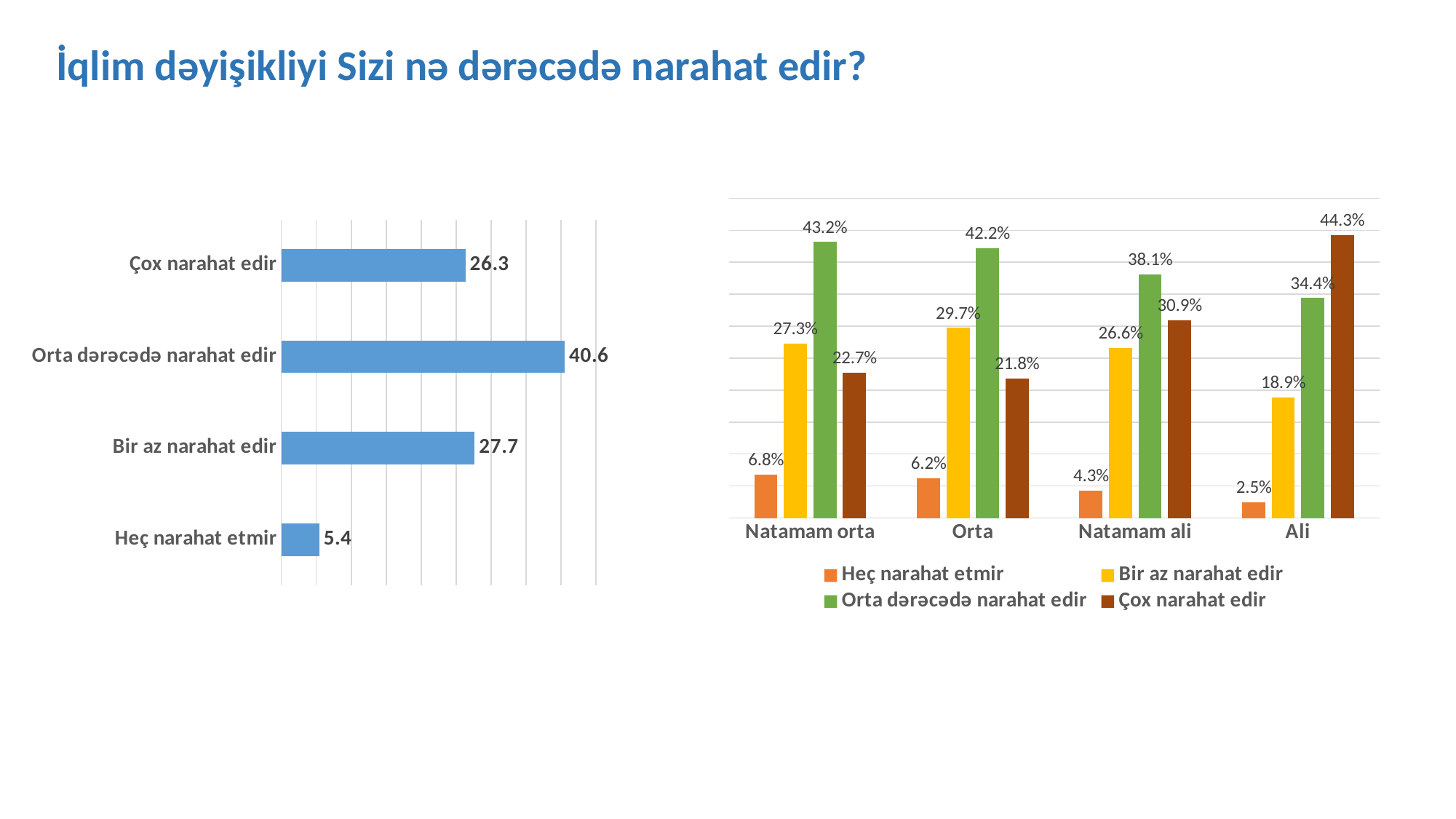
In the left chart, which category has the lowest value? Heç narahat etmir In the right chart, what is the value for "Çox narahat edir" in the "Ali" group? 44.3% In the right chart, does the value for "Heç narahat etmir" rise or fall from "Natamam orta" to "Ali"? Fall In the left chart, which category has the highest value? Orta dərəcədə narahat edir In the left chart, what is the value for "Orta dərəcədə narahat edir"? 40.6 How many categories does the left chart show? 4 What kind of chart is the left chart? Bar chart How many series does the legend of the right chart list? 4 In the right chart, is the value for "Bir az narahat edir" larger in the "Orta" group or the "Ali" group? Orta In the right chart, which group has the highest value for "Orta dərəcədə narahat edir"? Natamam orta In the right chart, what is the value for "Heç narahat etmir" in the "Natamam orta" group? 6.8% In the left chart, what is the difference between the values for "Bir az narahat edir" and "Çox narahat edir"? 1.4